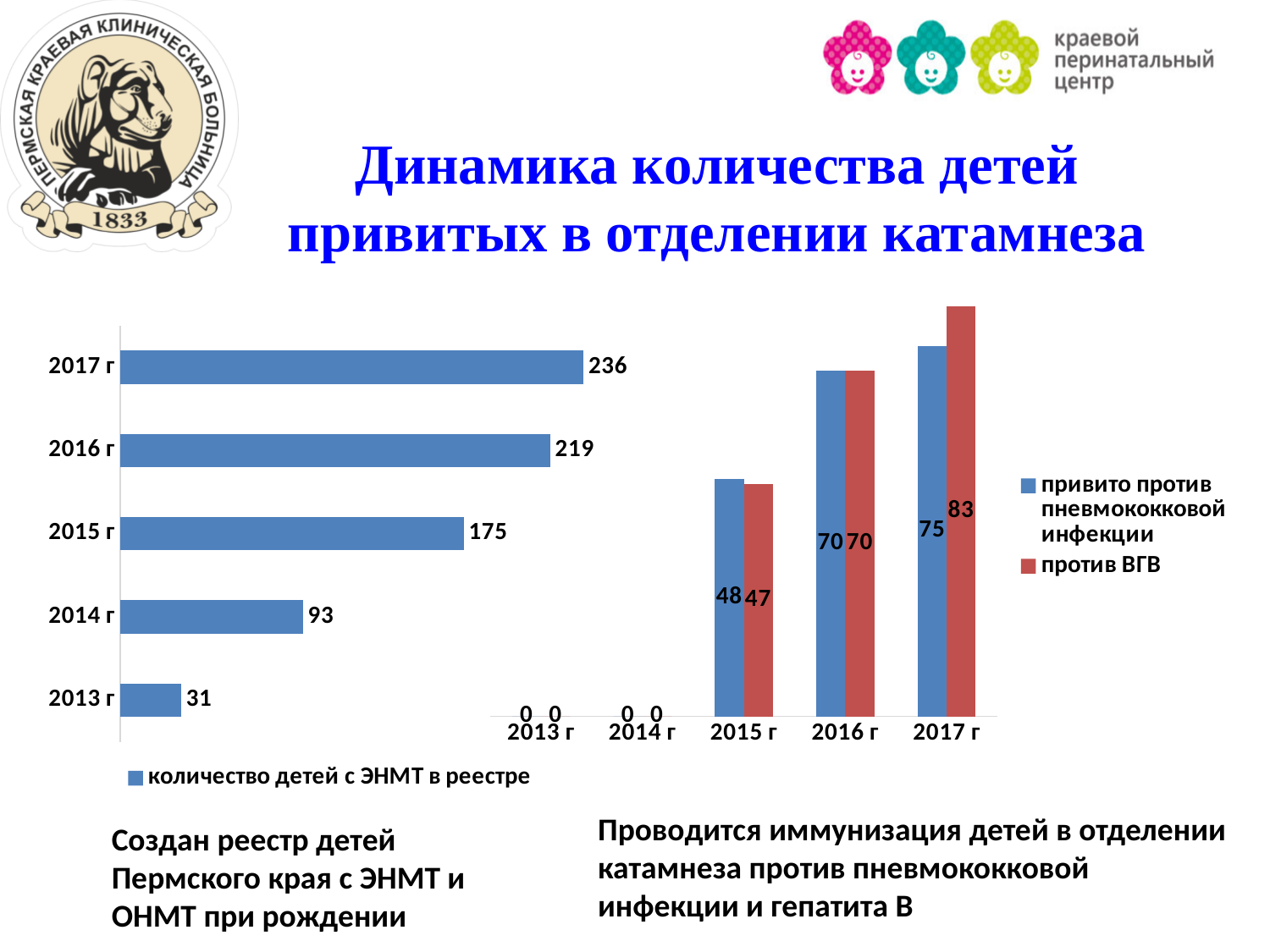
On the right chart, how many series does the legend list? 2 On the left chart, how many years are shown? 5 On the left chart, what is the difference between the values for 2016 г and 2015 г? 44 On the left chart, which year has the lowest value? 2013 г On the right chart, what is the value for привито против пневмококковой инфекции in 2015 г? 48 On the left chart, what is the value for 2017 г? 236 On the left chart, do the values rise or fall from 2013 г to 2017 г? rise On the left chart, what is the value for 2014 г? 93 What kind of chart is the left chart? bar chart On the right chart, what is the value for против ВГВ in 2017 г? 83 On the right chart, what is the difference between против ВГВ in 2017 г and in 2016 г? 13 On the right chart, which is larger in 2017 г: привито против пневмококковой инфекции or против ВГВ? против ВГВ